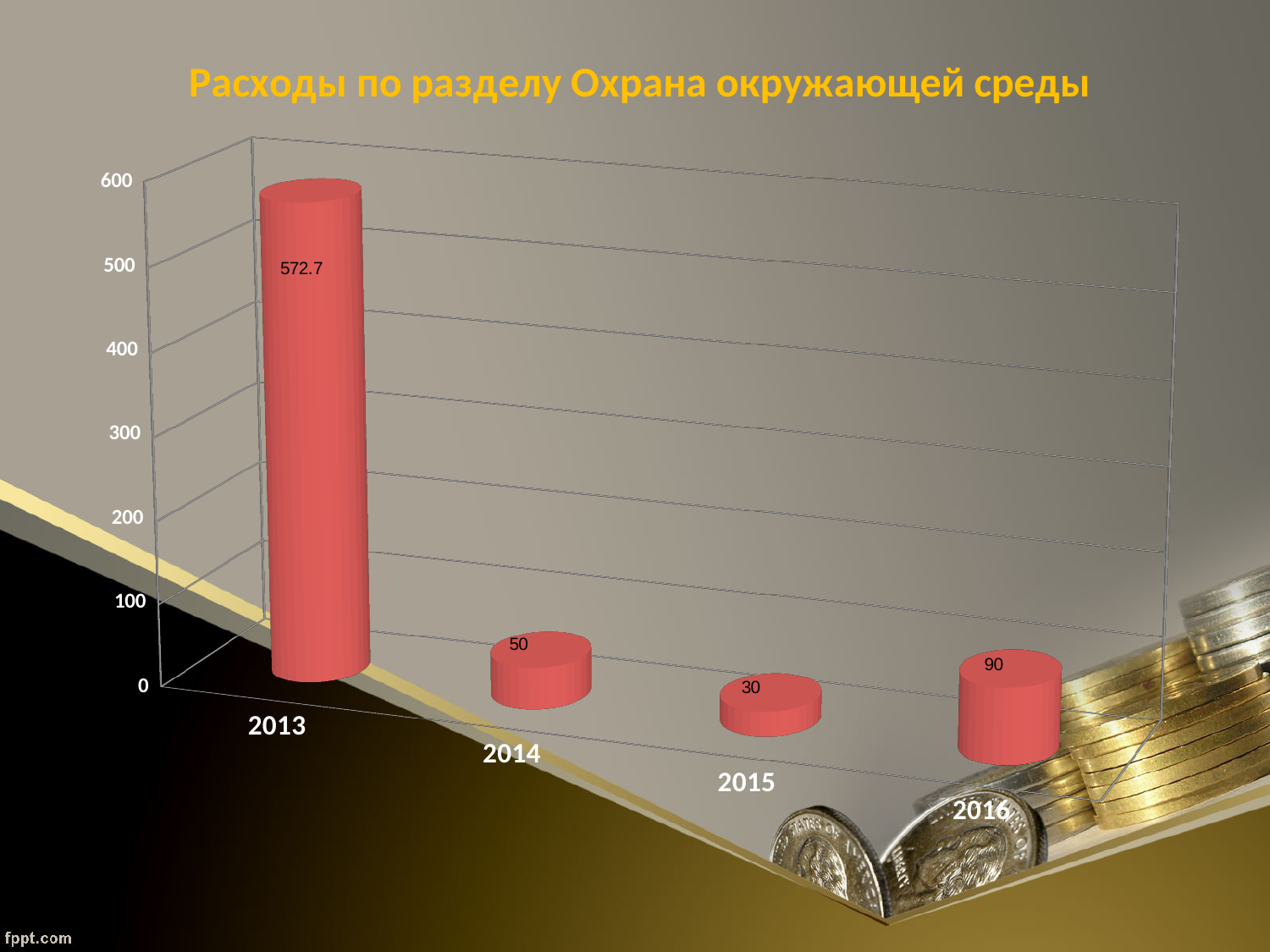
Which year has the highest value? 2013 What is the value for 2015? 30 Is the value for 2013 greater or less than 500? greater What is the difference between the values for 2016 and 2014? 40 How many years are shown on the chart? 4 What is the difference between the values for 2013 and 2016? 482.7 What is the title of the chart? Расходы по разделу Охрана окружающей среды Which is larger, the value for 2014 or the value for 2015? 2014 What is the value for 2013? 572.7 What is the value for 2016? 90 Which year has the lowest value? 2015 What is the value for 2014? 50